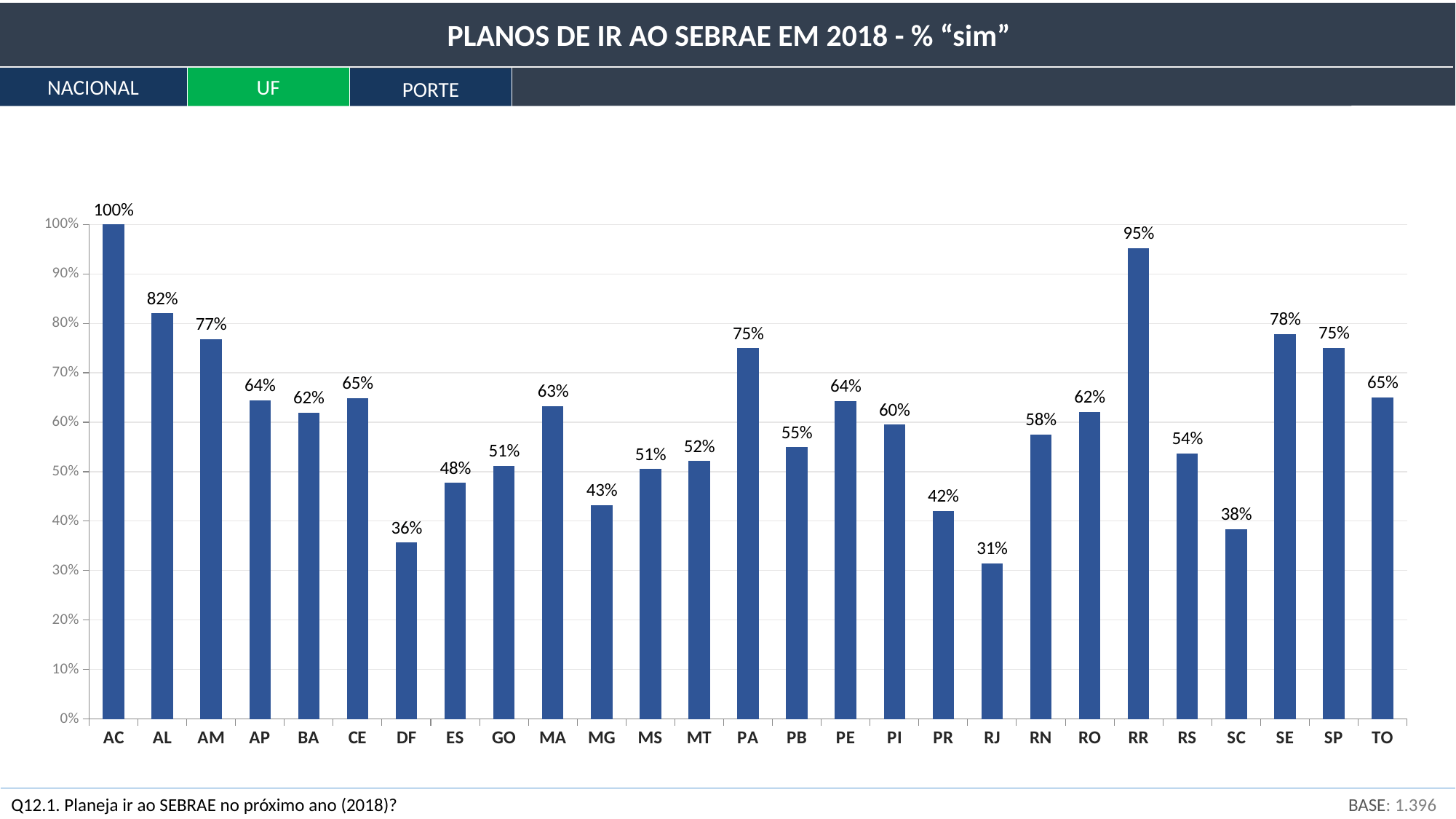
How many states (UF) are shown on the x axis? 27 What is the value for PA? 75% What is the title of the chart? PLANOS DE IR AO SEBRAE EM 2018 - % "sim" Which state has the highest value? AC What kind of chart is shown on the slide? bar chart Which state has the lowest value? RJ Which is larger, the value for MG or the value for MT? MT What is the value for RR? 95% What is the value for DF? 36% What is the difference between the values for AC and RJ? 69% What is the difference between the values for AL and SC? 44% Is the value for PR greater or less than 50%? less